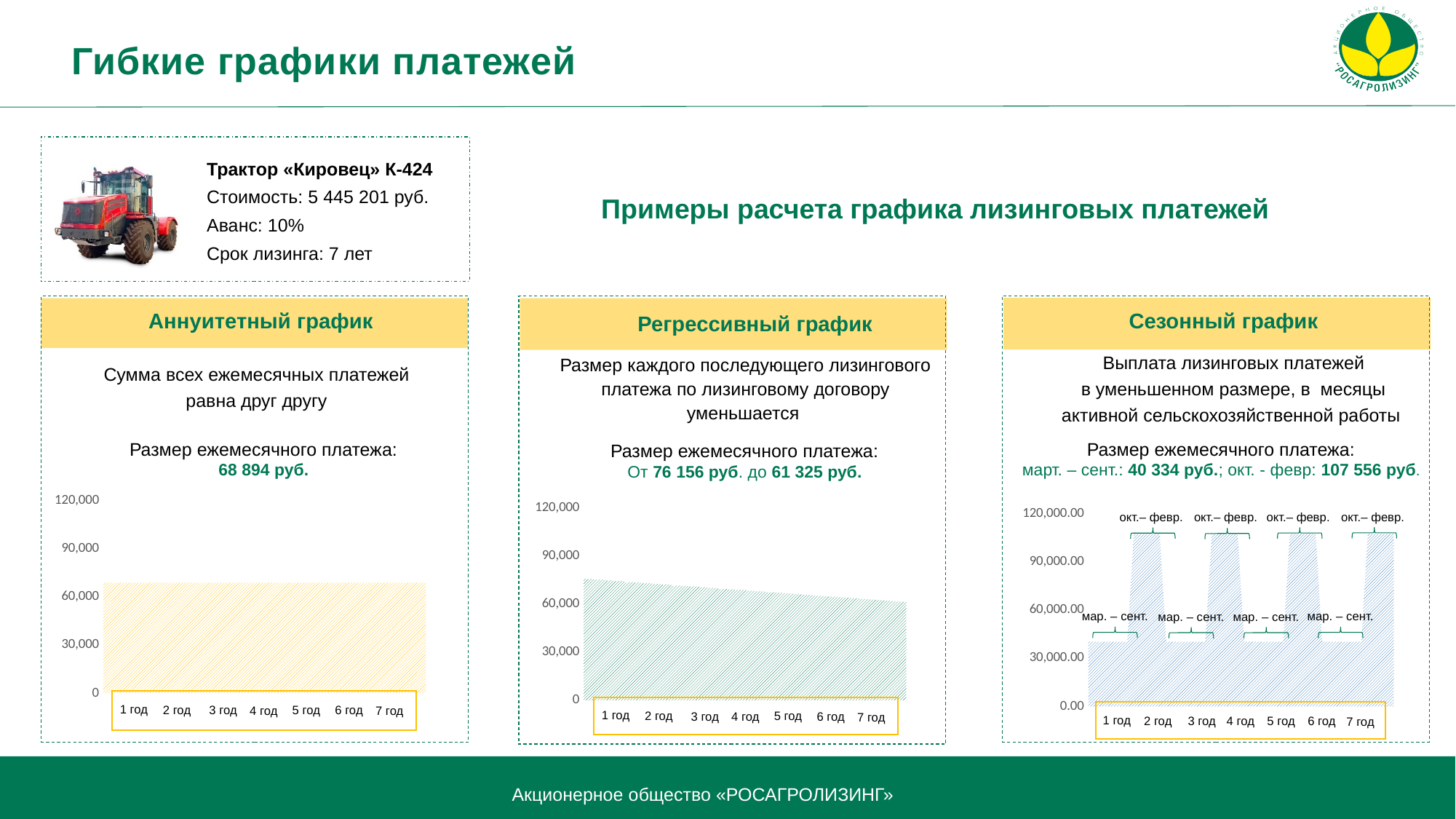
In the Сезонный график chart, is the value in the мар. – сент. periods greater or less than 60,000.00? less In the Аннуитетный график chart, is the value for 1 год greater or less than 90,000? less How many year categories are shown on the x axis of the Аннуитетный график chart? 7 In the Сезонный график chart, is the value in the окт.– февр. periods greater or less than 90,000.00? greater In the Регрессивный график chart, do the values rise or fall from 1 год to 7 год? fall In the Аннуитетный график chart, do the values rise, fall or stay flat from 1 год to 7 год? stay flat Which of the three charts shows payments that decrease every year? Регрессивный график What kind of chart is used in the Регрессивный график panel? area chart How many окт.– февр. peaks are labelled in the Сезонный график chart? 4 What is the highest tick label on the vertical axis of the Сезонный график chart? 120,000.00